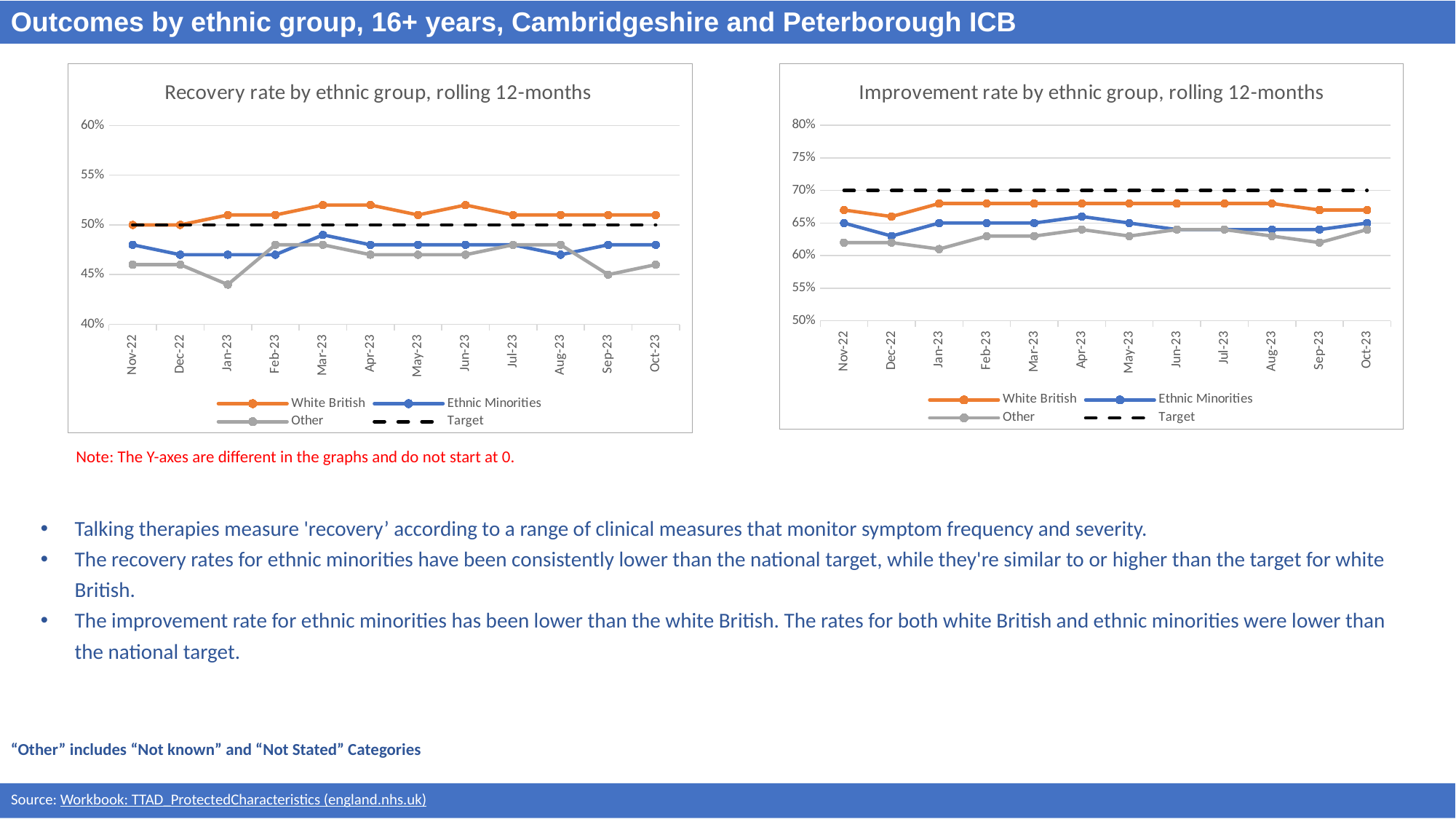
In the 'Recovery rate by ethnic group, rolling 12-months' chart, which is larger in Jan-23: Ethnic Minorities or Other? Ethnic Minorities How many months are plotted along the x axis of the 'Recovery rate by ethnic group, rolling 12-months' chart? 12 In the 'Improvement rate by ethnic group, rolling 12-months' chart, is the value for Other in Jan-23 greater or less than 65%? less In the 'Recovery rate by ethnic group, rolling 12-months' chart, what value does the Target line sit at? 50% What kind of chart is the 'Recovery rate by ethnic group, rolling 12-months' chart? Line chart What is the title of the chart on the right of the slide? Improvement rate by ethnic group, rolling 12-months In the 'Improvement rate by ethnic group, rolling 12-months' chart, what value does the Target line sit at? 70% In the 'Recovery rate by ethnic group, rolling 12-months' chart, is the value for Other in Jan-23 greater or less than 45%? less How many series does the legend of the 'Improvement rate by ethnic group, rolling 12-months' chart list? 4 In the 'Recovery rate by ethnic group, rolling 12-months' chart, which ethnic group series has the highest value in Oct-23? White British In the 'Improvement rate by ethnic group, rolling 12-months' chart, is the value for White British in Jan-23 greater or less than 65%? greater In the 'Improvement rate by ethnic group, rolling 12-months' chart, which is larger in Apr-23: White British or Ethnic Minorities? White British